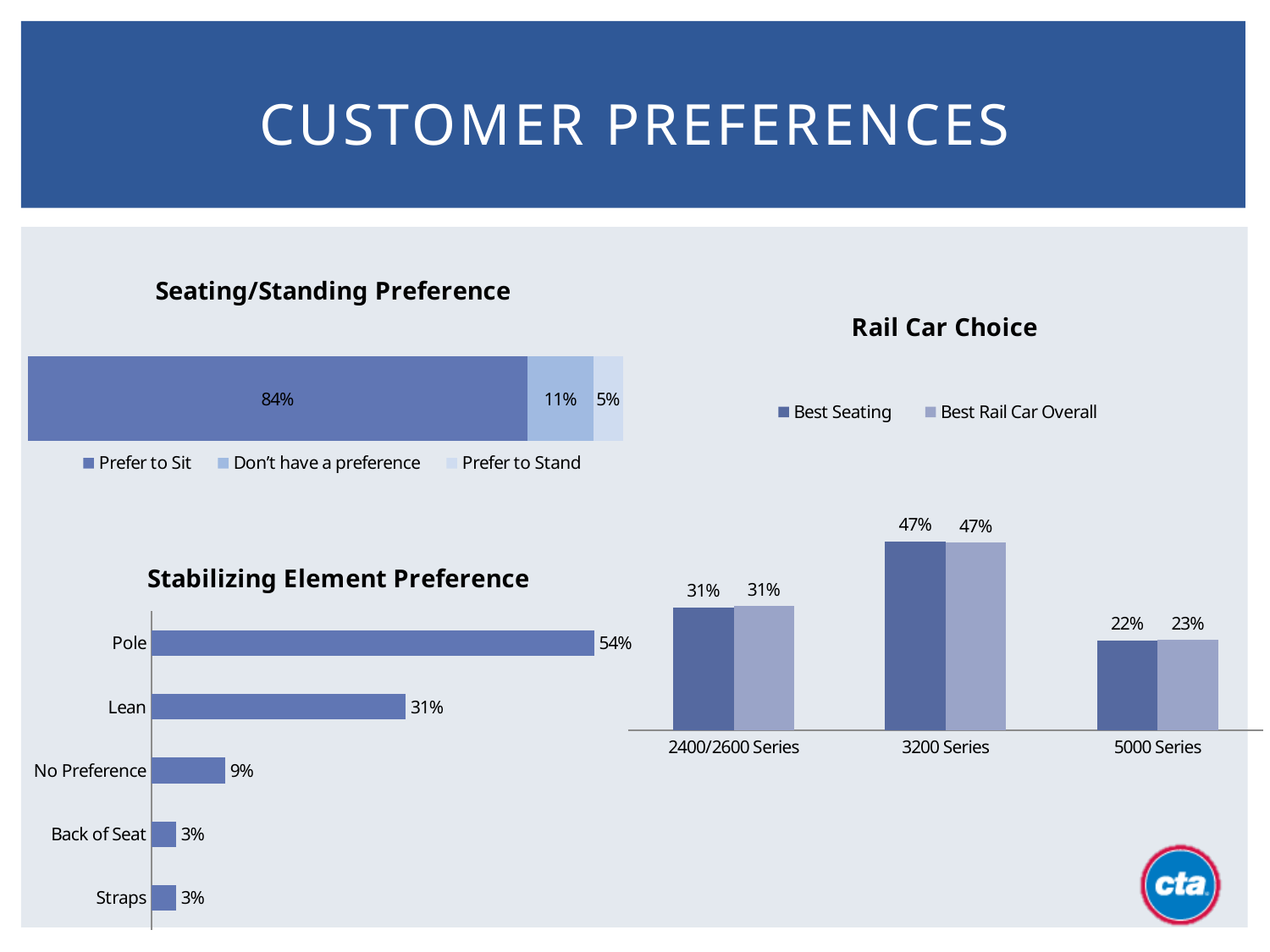
In the Stabilizing Element Preference chart, which category has the highest value? Pole What kind of chart is the Stabilizing Element Preference chart? Bar chart In the Seating/Standing Preference chart, how many series does the legend list? 3 In the Rail Car Choice chart, which series of rail car has the highest Best Seating value? 3200 Series In the Seating/Standing Preference chart, what percentage of customers prefer to stand? 5% In the Seating/Standing Preference chart, what percentage of customers prefer to sit? 84% In the Stabilizing Element Preference chart, what is the difference between the values for Pole and Lean? 23% In the Stabilizing Element Preference chart, how many categories are shown? 5 In the Stabilizing Element Preference chart, what is the value for Lean? 31% In the Rail Car Choice chart, what is the Best Rail Car Overall value for the 5000 Series? 23% In the Rail Car Choice chart, what is the difference between the Best Seating values for the 3200 Series and the 2400/2600 Series? 16% In the Seating/Standing Preference chart, what is the total of the stacked bar? 100%